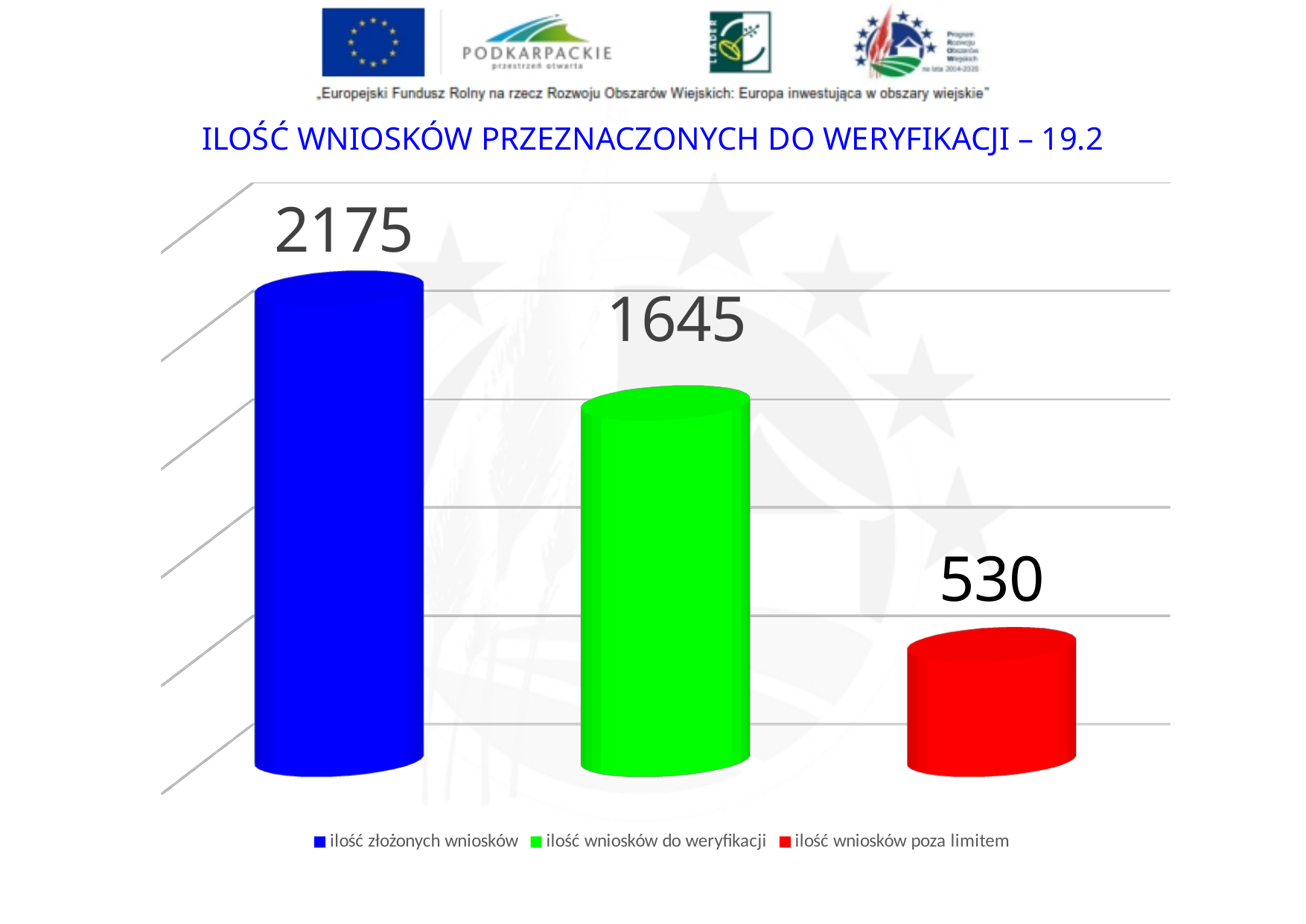
What is the difference between "ilość złożonych wniosków" and "ilość wniosków do weryfikacji"? 530 What is the value for "ilość wniosków poza limitem"? 530 What kind of chart is shown on the slide? bar chart What is the value for "ilość złożonych wniosków"? 2175 Which series has the lowest value? ilość wniosków poza limitem Which is larger: "ilość wniosków do weryfikacji" or "ilość wniosków poza limitem"? ilość wniosków do weryfikacji What colour is the bar for "ilość wniosków poza limitem"? red What is the value for "ilość wniosków do weryfikacji"? 1645 What is the difference between "ilość wniosków do weryfikacji" and "ilość wniosków poza limitem"? 1115 Which series has the highest value? ilość złożonych wniosków How many series does the legend list? 3 What is the title of the chart? ILOŚĆ WNIOSKÓW PRZEZNACZONYCH DO WERYFIKACJI – 19.2